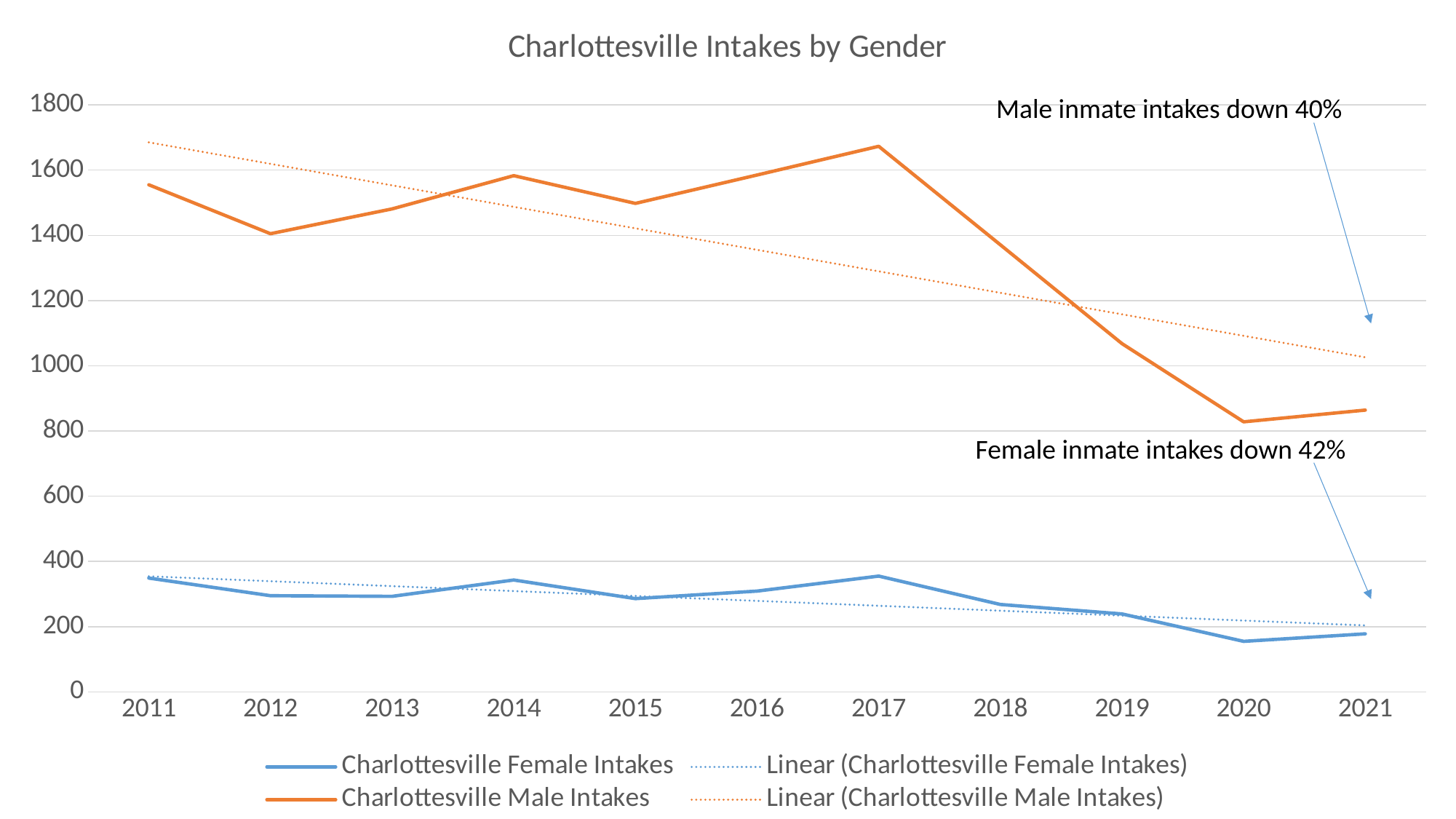
In which year were Charlottesville Male Intakes lowest? 2020 In which year were Charlottesville Female Intakes lowest? 2020 What is the title of the chart? Charlottesville Intakes by Gender Which year had more Charlottesville Male Intakes, 2014 or 2015? 2014 How many entries does the legend list? 4 What kind of chart is shown on the slide? line chart How many years are shown on the x axis? 11 In which year were Charlottesville Male Intakes highest? 2017 Is the value for Charlottesville Female Intakes in 2020 greater or less than 200? less Is the value for Charlottesville Male Intakes in 2017 greater or less than 1600? greater Is the value for Charlottesville Male Intakes in 2020 greater or less than 1000? less Do Charlottesville Male Intakes rise or fall from 2017 to 2020? fall